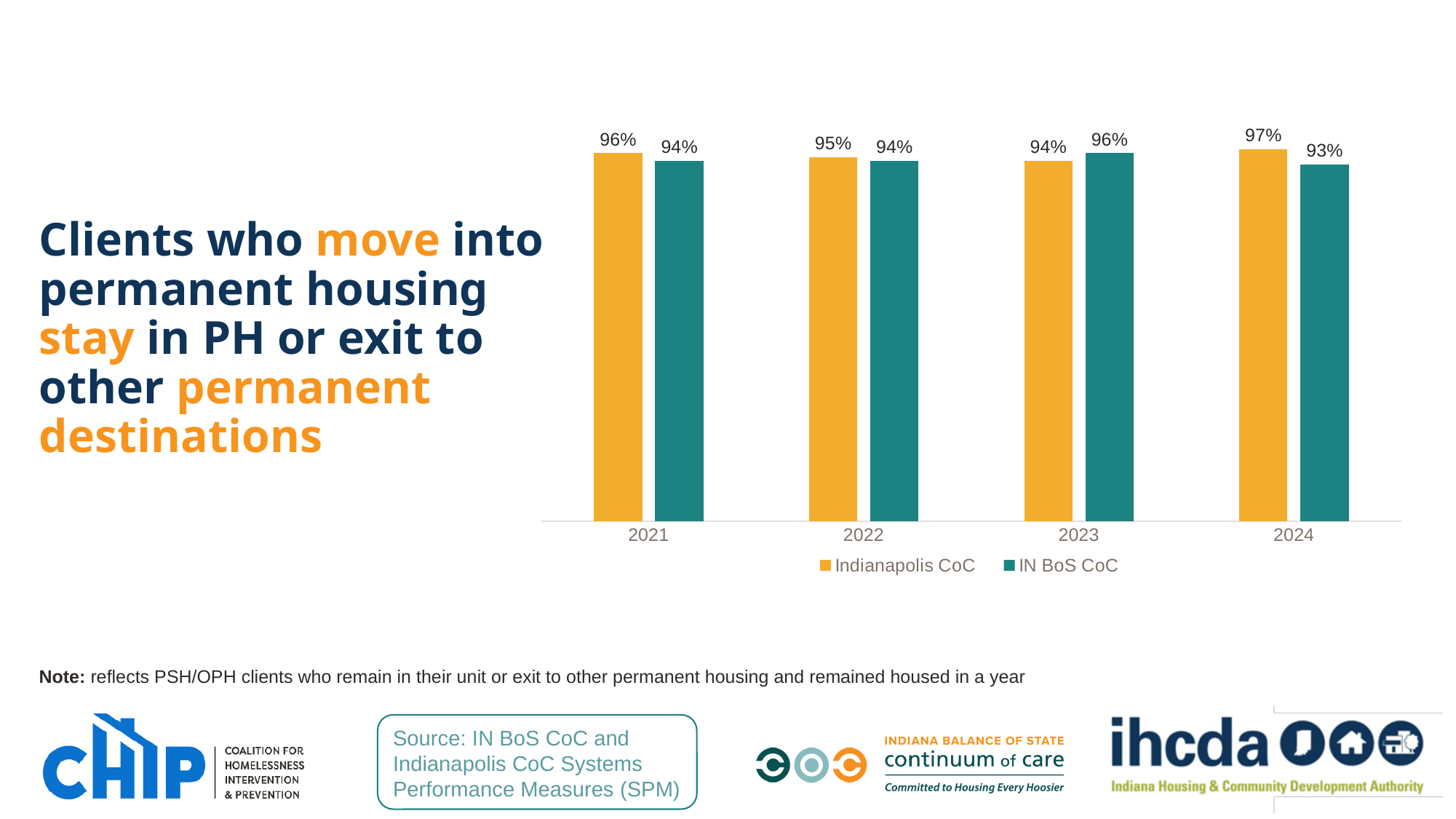
In which year is the Indianapolis CoC value highest? 2024 Which colour represents Indianapolis CoC in the chart? Orange What is the value for IN BoS CoC in 2024? 93% How many years are shown on the x axis? 4 How many series does the legend list? 2 What kind of chart is shown on the slide? Bar chart What is the difference between the Indianapolis CoC and IN BoS CoC values in 2024? 4% What is the value for Indianapolis CoC in 2022? 95% What is the value for Indianapolis CoC in 2021? 96% In 2023, which series has the larger value, Indianapolis CoC or IN BoS CoC? IN BoS CoC In which year is the IN BoS CoC value lowest? 2024 What is the value for IN BoS CoC in 2023? 96%